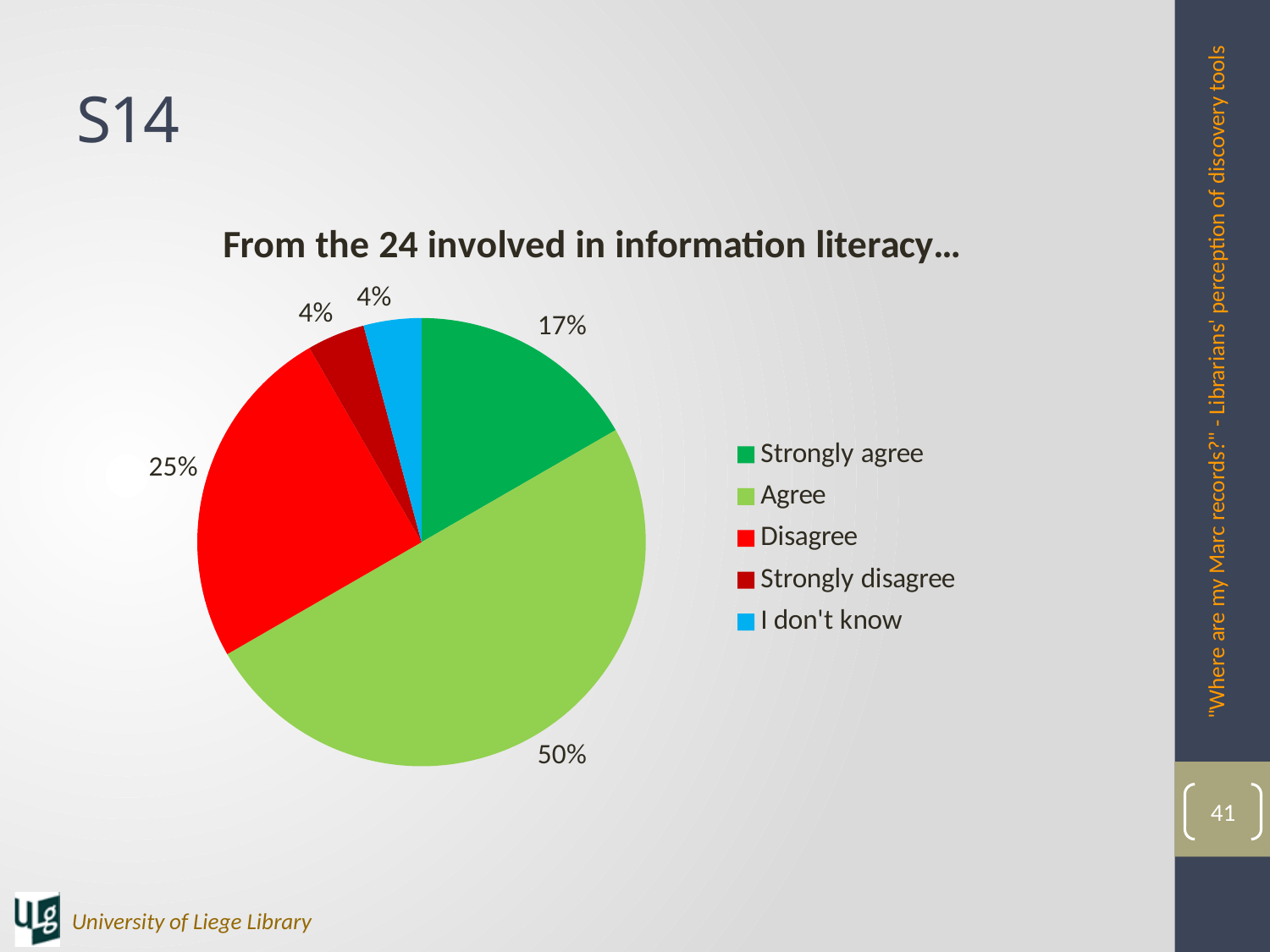
What is the title of the chart? From the 24 involved in information literacy… How many categories does the legend list? 5 What colour is the Disagree slice? red Which category has the largest slice of the pie? Agree What percentage of the pie is labelled for Disagree? 25% Which slice is larger, Strongly agree or Disagree? Disagree What percentage of the pie is labelled for I don't know? 4% What percentage of the pie is labelled for Agree? 50% What kind of chart is shown on the slide? pie chart What is the difference in percentage points between the Agree and Disagree slices? 25 What percentage of the pie is labelled for Strongly agree? 17% What is the difference in percentage points between the Strongly agree and Strongly disagree slices? 13